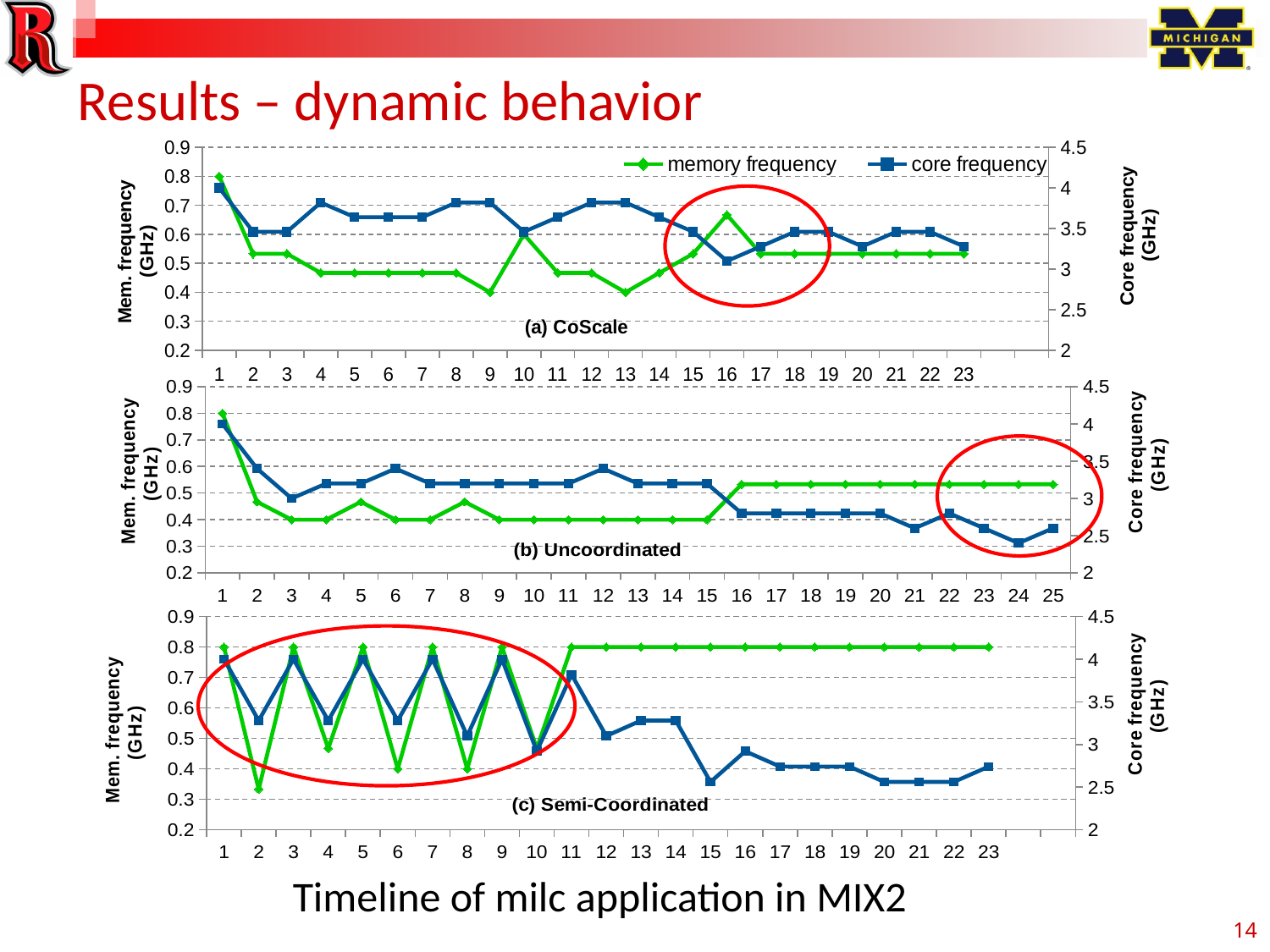
In the (c) Semi-Coordinated chart, is the memory frequency at time 2 greater or less than 0.4? less How many series does the legend on the (a) CoScale chart list? 2 Which colour is used for the memory frequency series in the legend? green In the (c) Semi-Coordinated chart, does the memory frequency rise, fall, or stay flat from time 11 to time 23? stays flat In the (c) Semi-Coordinated chart, is the core frequency at time 15 greater or less than 3? less In the (a) CoScale chart, is the core frequency at time 1 greater or less than 3.5? greater In the (b) Uncoordinated chart, how many time points are shown on the x axis? 25 What kind of chart is the (a) CoScale chart? line chart In the (c) Semi-Coordinated chart, how many time points are shown on the x axis? 23